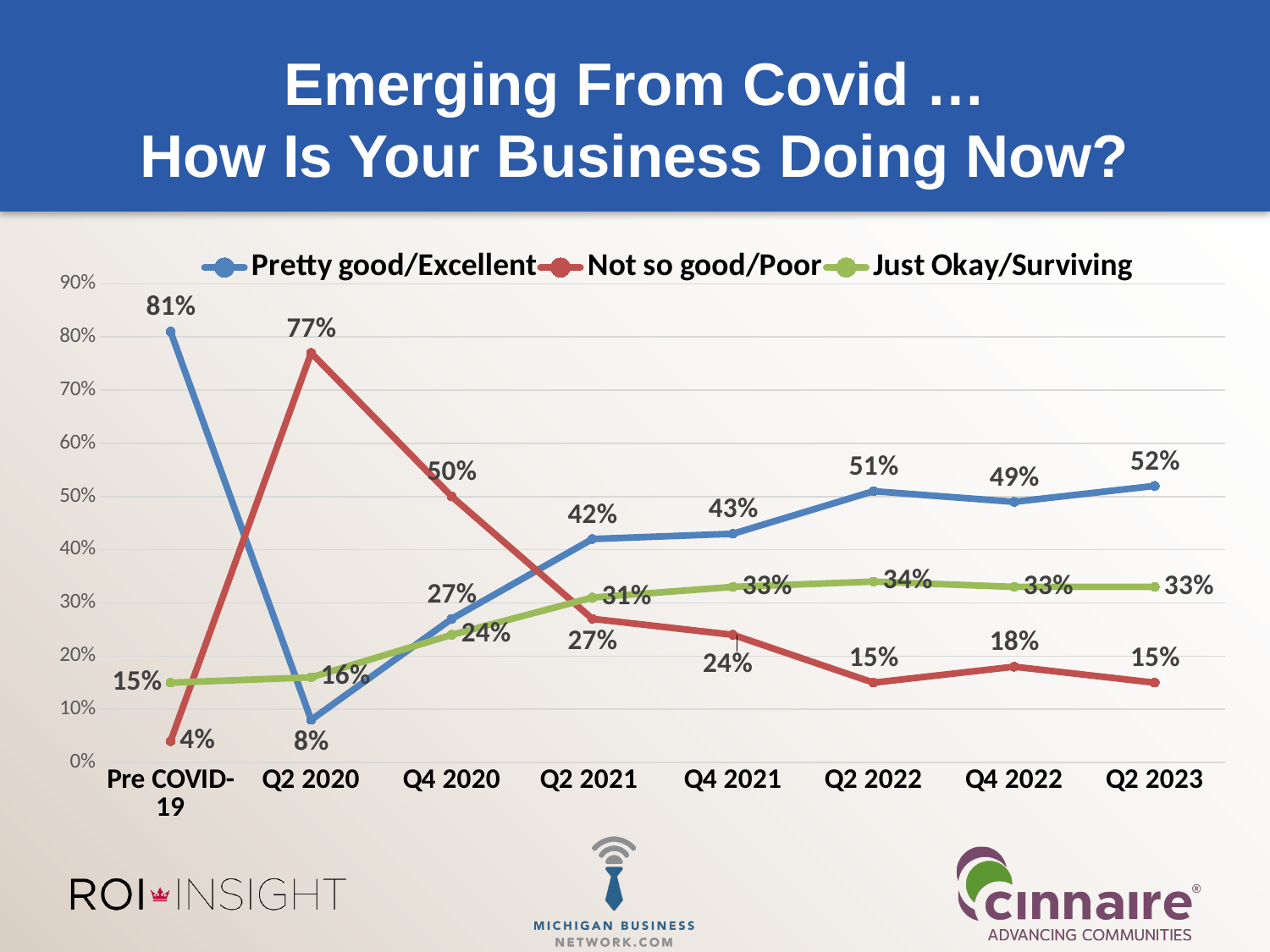
Which series is shown in green? Just Okay/Surviving How many time periods are shown on the x axis? 8 Does the Just Okay/Surviving series generally rise or fall from Pre COVID-19 to Q2 2022? rise In Q4 2020, which is larger: Not so good/Poor or Pretty good/Excellent? Not so good/Poor What is the value for Just Okay/Surviving in Q2 2022? 34% In which period is the Not so good/Poor series at its highest? Q2 2020 What is the value for Pretty good/Excellent at Pre COVID-19? 81% What is the difference between Pretty good/Excellent and Not so good/Poor in Q2 2023? 37% What is the value for Not so good/Poor in Q2 2020? 77% In which period is the Pretty good/Excellent series at its lowest? Q2 2020 What kind of chart is shown on the slide? line chart How many series does the legend list? 3